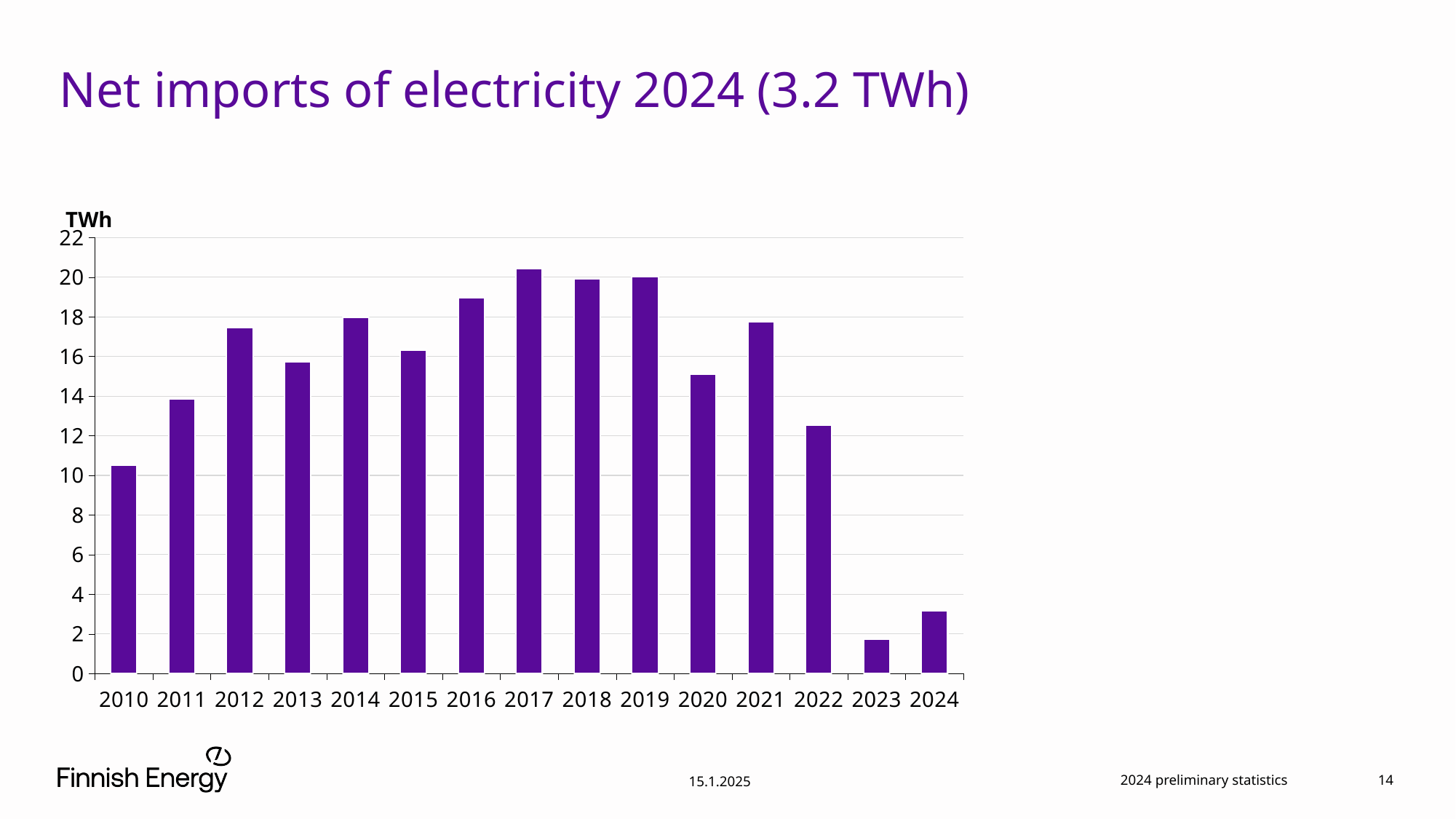
Which year has the lowest net imports of electricity? 2023 Which year has larger net imports, 2020 or 2021? 2021 How many years are shown on the x axis of the chart? 15 Is the value for 2016 greater or less than 18? greater What kind of chart is shown on the slide? bar chart Is the value for 2022 greater or less than 14? less What is the net import of electricity for 2024 according to the slide? 3.2 TWh Is the value for 2012 greater or less than 16? greater What unit is shown on the vertical axis of the chart? TWh Which year has larger net imports, 2010 or 2011? 2011 Which year has the highest net imports of electricity? 2017 Do the values rise or fall from 2019 to 2023? fall